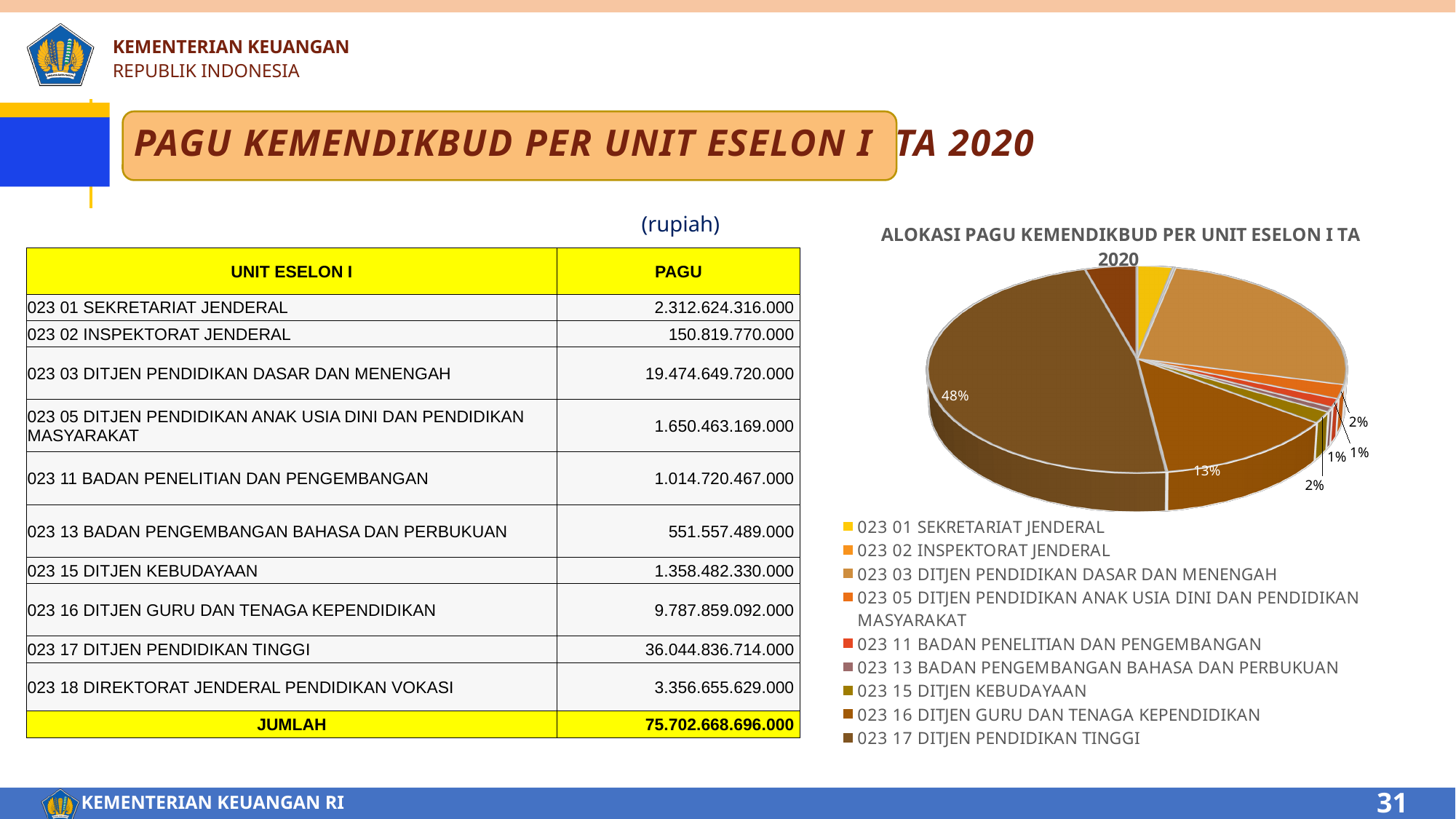
Is the share for 023 17 DITJEN PENDIDIKAN TINGGI greater or less than 50%? less What share of the pie does 023 16 DITJEN GURU DAN TENAGA KEPENDIDIKAN hold? 13% In the pie chart, which slice is larger: 023 03 DITJEN PENDIDIKAN DASAR DAN MENENGAH or 023 16 DITJEN GURU DAN TENAGA KEPENDIDIKAN? 023 03 DITJEN PENDIDIKAN DASAR DAN MENENGAH How many entries does the pie chart's legend list? 9 In the pie chart, which slice is larger: 023 17 DITJEN PENDIDIKAN TINGGI or 023 03 DITJEN PENDIDIKAN DASAR DAN MENENGAH? 023 17 DITJEN PENDIDIKAN TINGGI By how many percentage points does the share of 023 17 DITJEN PENDIDIKAN TINGGI exceed that of 023 16 DITJEN GURU DAN TENAGA KEPENDIDIKAN? 35 percentage points What is the title of the pie chart? ALOKASI PAGU KEMENDIKBUD PER UNIT ESELON I TA 2020 Which unit has the largest slice in the pie chart? 023 17 DITJEN PENDIDIKAN TINGGI What kind of chart is shown on the slide? pie chart What colour does the legend use for 023 01 SEKRETARIAT JENDERAL? yellow What share of the pie does 023 17 DITJEN PENDIDIKAN TINGGI hold? 48%